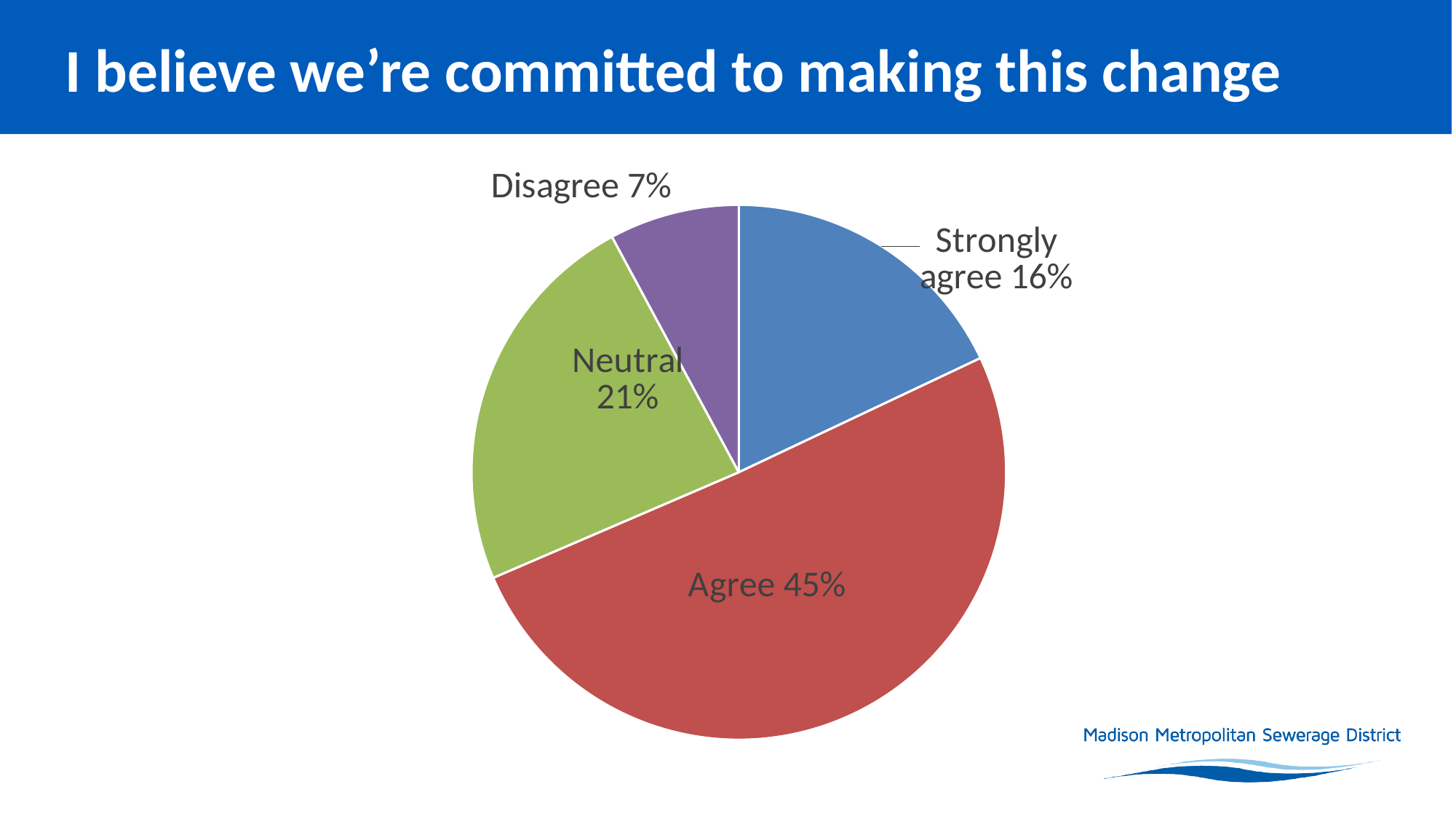
What percentage of respondents chose Disagree? 7% What is the title of the slide containing the pie chart? I believe we're committed to making this change Which response has the smallest share of the pie? Disagree What is the difference in percentage points between Agree and Neutral? 24 Which response has the largest share of the pie? Agree What percentage of respondents chose Strongly agree? 16% What kind of chart is shown on the slide? pie chart What is the combined share of Strongly agree and Agree? 61% What percentage of respondents chose Neutral? 21% How many slices does the pie chart have? 4 What percentage of respondents chose Agree? 45% Which is larger, the share for Neutral or the share for Strongly agree? Neutral